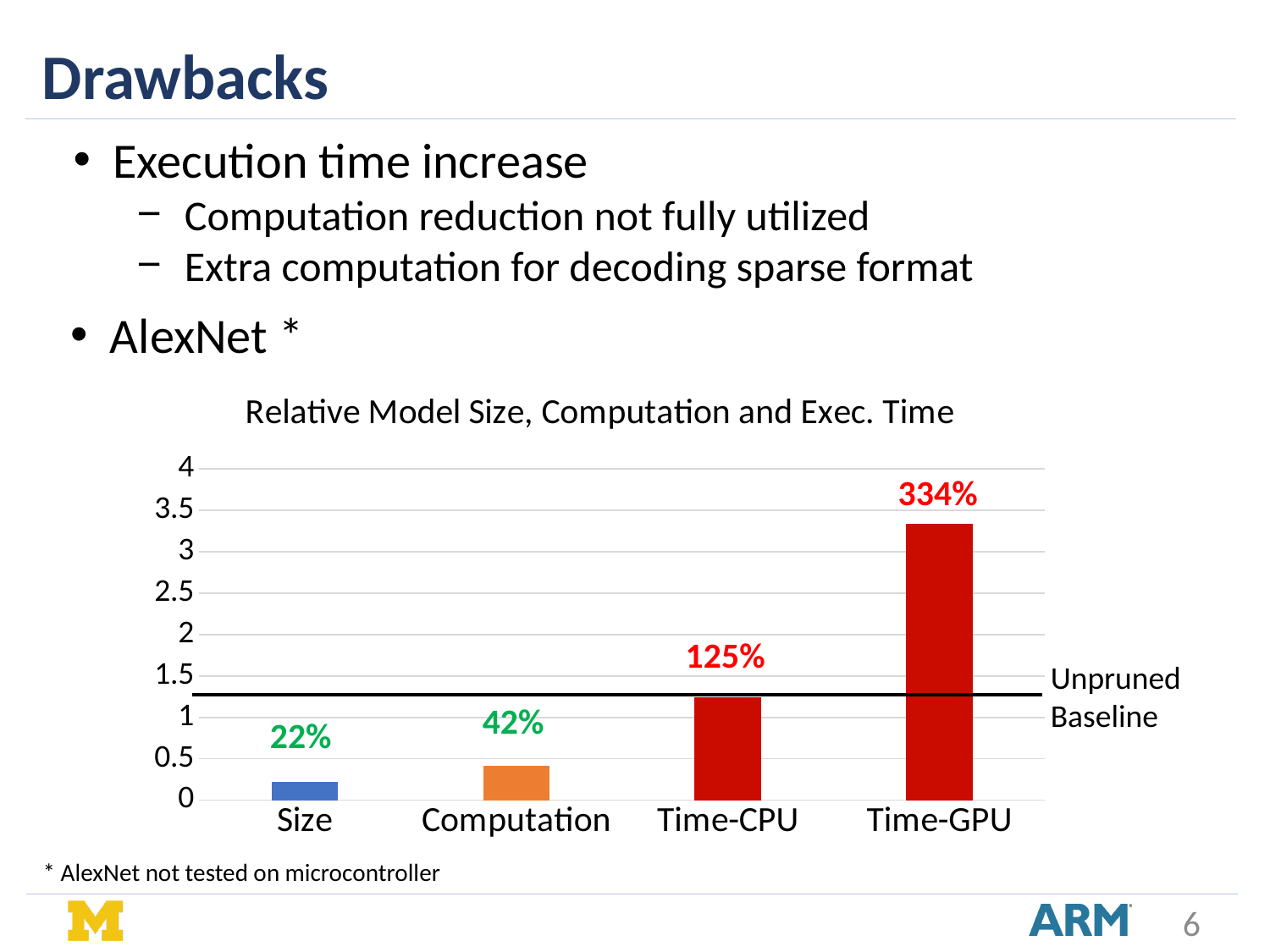
What is the difference between the Time-GPU and Time-CPU values? 209% What is the title of the chart? Relative Model Size, Computation and Exec. Time Is the bar for Time-GPU greater or less than 3 on the y axis? greater What is the value shown for Computation? 42% What is the value shown for Time-CPU? 125% Which category has the lowest value? Size What kind of chart is shown on the slide? bar chart What is the value shown for Time-GPU? 334% What is the value shown for Size? 22% Which category has the highest value? Time-GPU How many categories are shown on the x axis? 4 Which is larger, the value for Computation or the value for Size? Computation